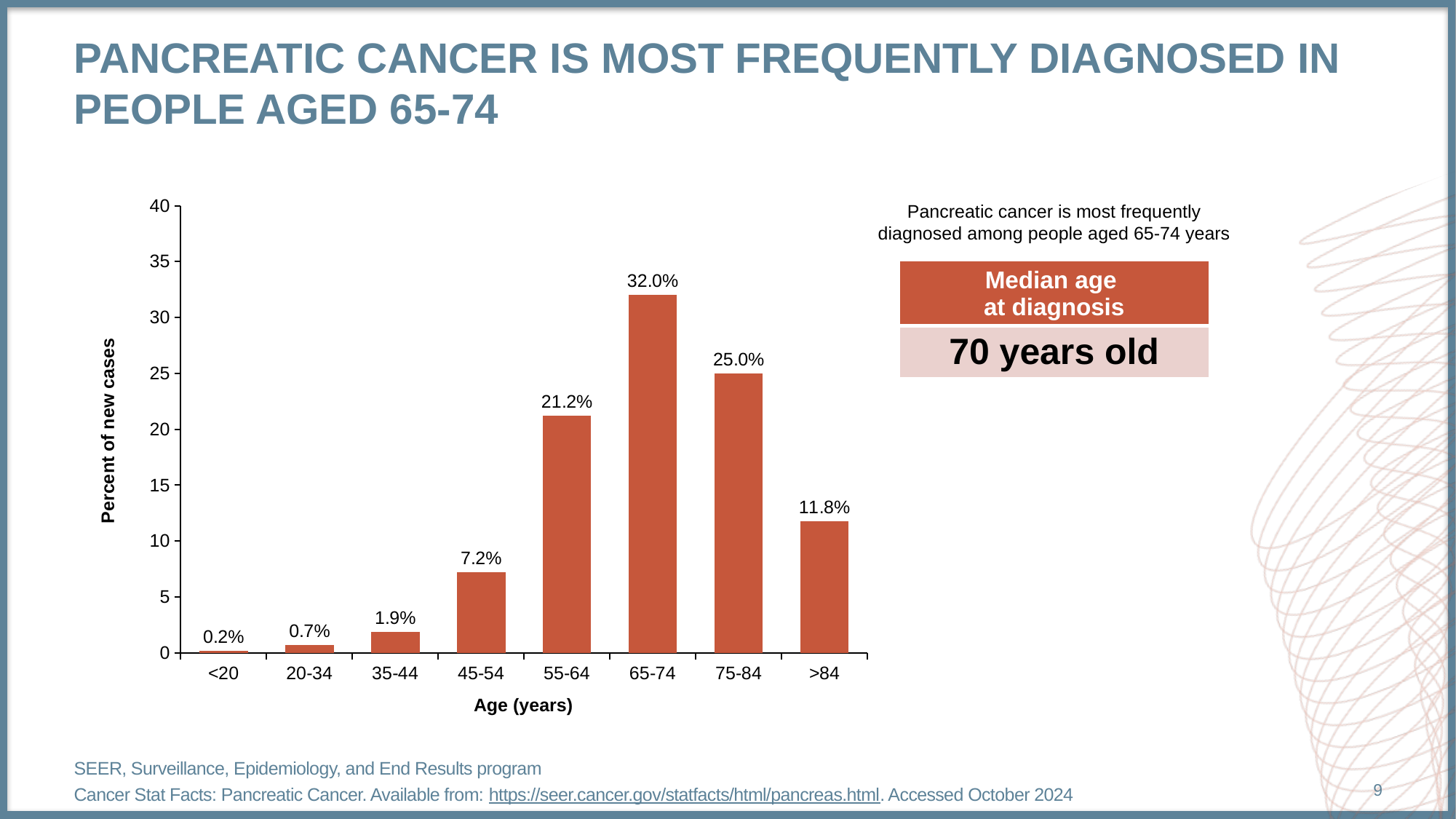
What is the difference in percent of new cases between the 65-74 and 75-84 age groups? 7.0% What percent of new cases is shown for the 65-74 age group? 32.0% What kind of chart is shown on the slide? Bar chart Which age group has a larger percent of new cases, 55-64 or >84? 55-64 What percent of new cases is shown for the >84 age group? 11.8% What is the label of the x axis? Age (years) Do the values rise or fall from the <20 age group to the 65-74 age group? Rise What is the label of the y axis? Percent of new cases How many age groups are shown on the x axis? 8 Which age group has the highest percent of new cases? 65-74 Which age group has the lowest percent of new cases? <20 What percent of new cases is shown for the 45-54 age group? 7.2%